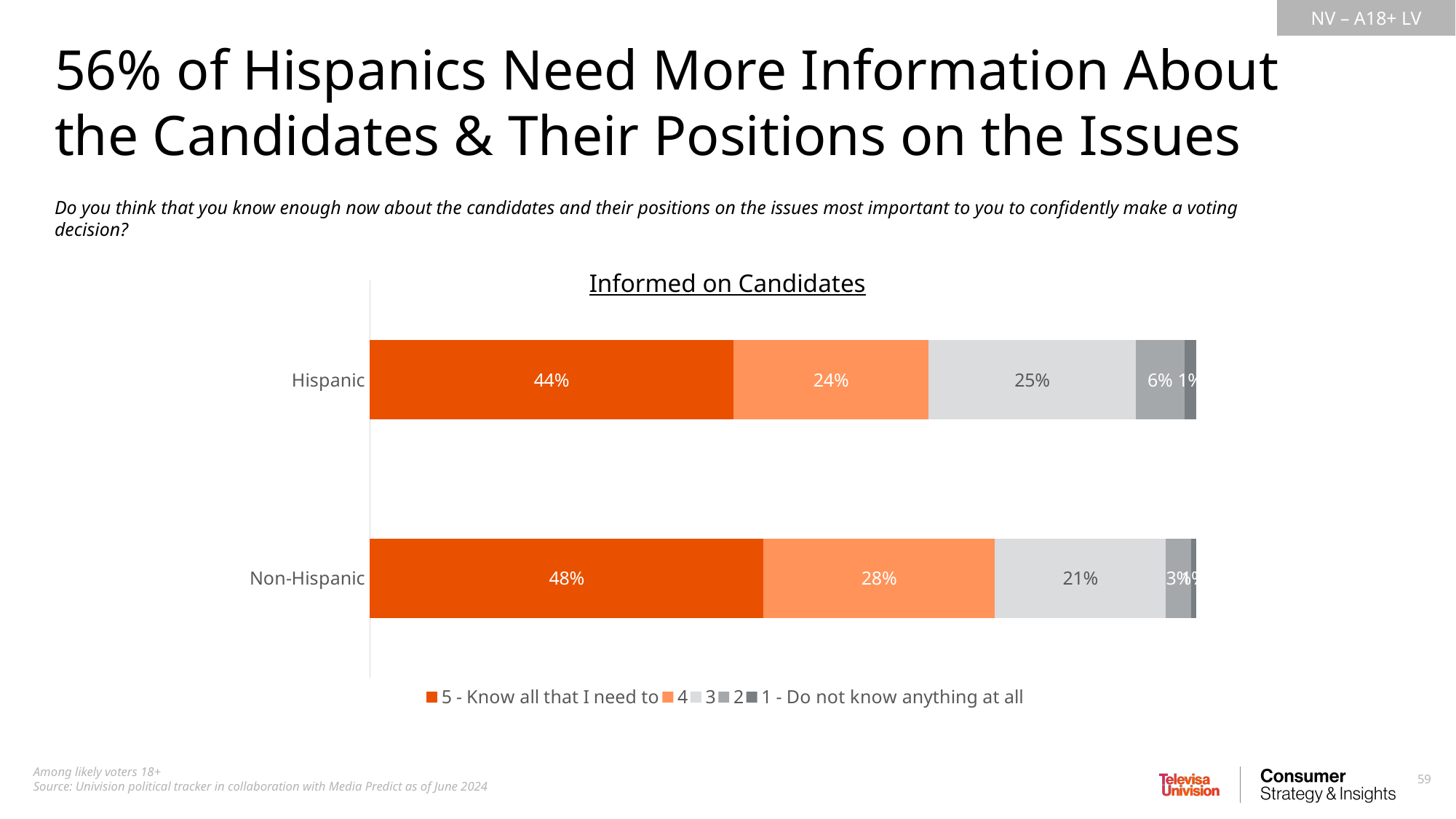
What percentage of Hispanic respondents answered '5 - Know all that I need to'? 44% What kind of chart is shown on the slide? Stacked bar chart What is the title of the chart? Informed on Candidates What is the difference between the Hispanic and Non-Hispanic shares giving a rating of 3? 4 percentage points What percentage of Non-Hispanic respondents gave a rating of 4? 28% What percentage of Hispanic respondents gave a rating of 3? 25% What percentage of Non-Hispanic respondents answered '5 - Know all that I need to'? 48% What percentage of Hispanic respondents gave a rating of 2? 6% What is the difference between the Non-Hispanic and Hispanic shares answering '5 - Know all that I need to'? 4 percentage points Which group has the larger share answering '5 - Know all that I need to', Hispanic or Non-Hispanic? Non-Hispanic How many groups (categories) are shown on the chart? 2 How many series does the legend list? 5